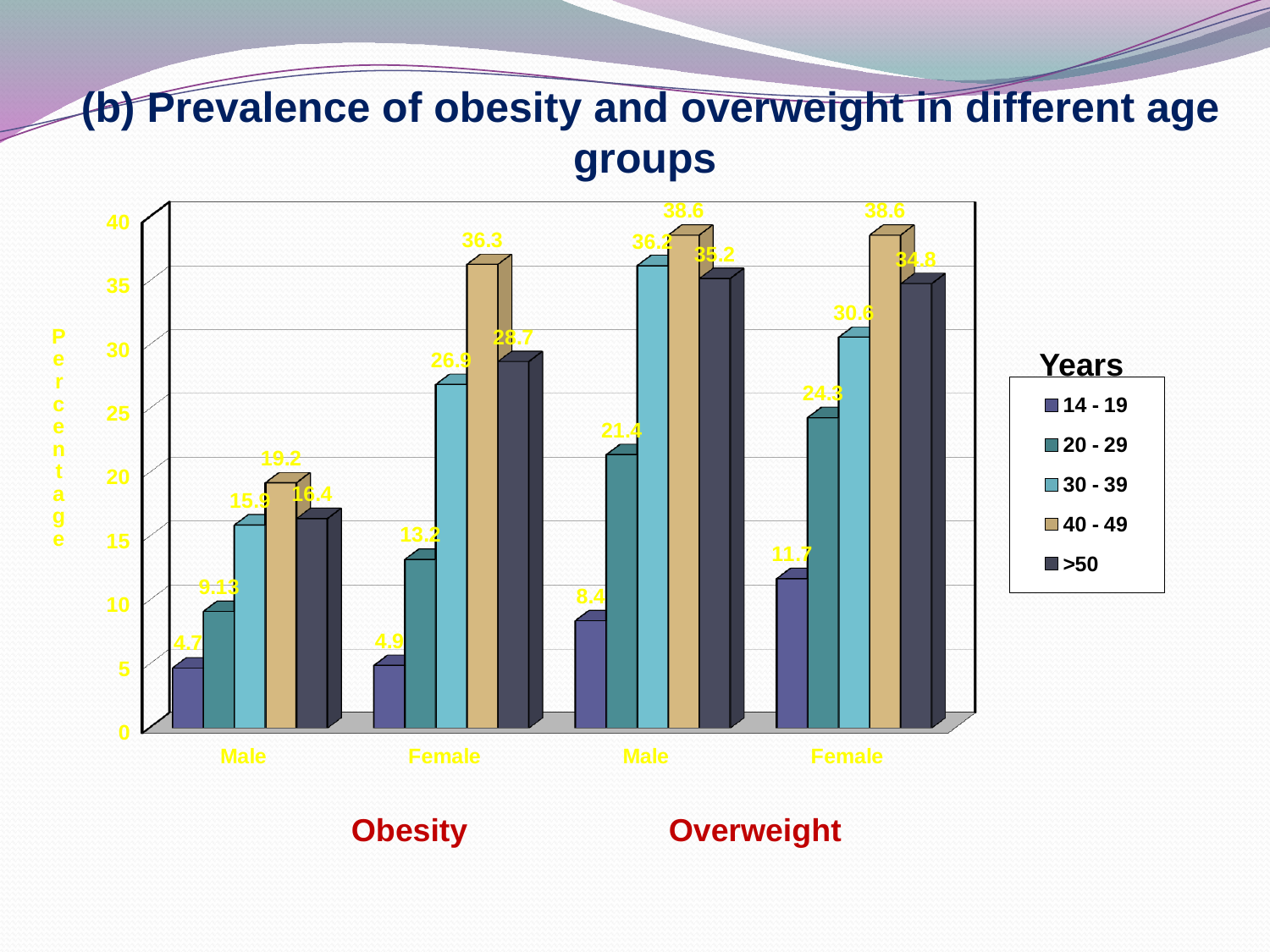
How many series does the legend list? 5 Which is larger: the overweight prevalence for males aged 30 - 39 or for females aged 30 - 39? males aged 30 - 39 Which age group has the highest obesity prevalence among females? 40 - 49 What is the title of the legend? Years Which age group has the lowest overweight prevalence among males? 14 - 19 What is the obesity prevalence for females aged 40 - 49? 36.3 What is the obesity prevalence for males aged 14 - 19? 4.7 How many category groups are shown along the x axis? 4 What is the overweight prevalence for females aged >50? 34.8 What type of chart is shown on the slide? bar chart What is the difference between the obesity prevalence of females aged 30 - 39 and males aged 30 - 39? 11 What is the overweight prevalence for males aged 20 - 29? 21.4